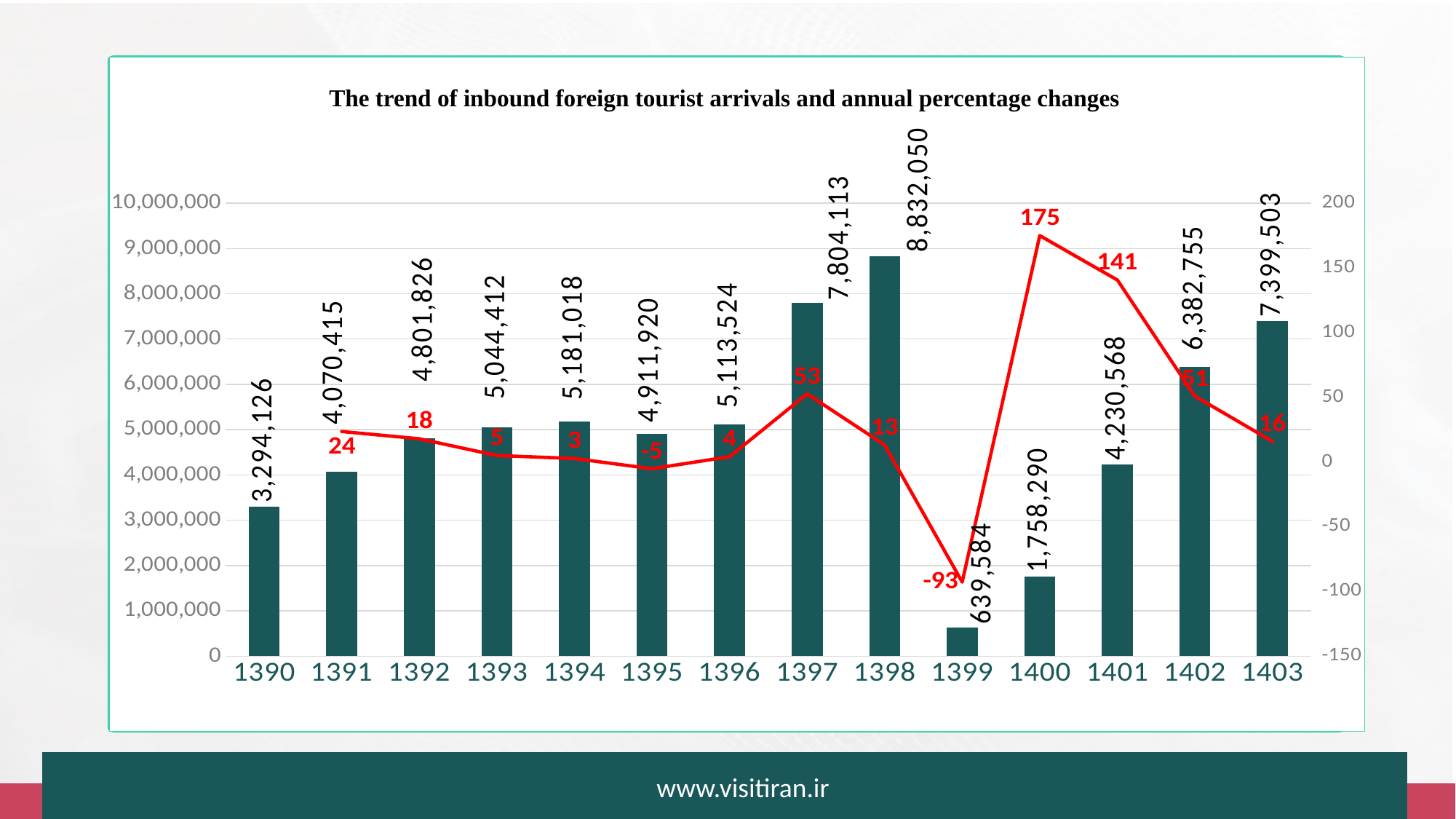
Which year has the lowest annual percentage change on the red line? 1399 Do tourist arrivals rise or fall from 1399 to 1403? Rise Which year has the lowest number of tourist arrivals? 1399 What is the number of inbound foreign tourist arrivals in 1398? 8,832,050 What is the difference in tourist arrivals between 1398 and 1397? 1,027,937 Which year has the highest number of tourist arrivals? 1398 What annual percentage change is shown on the red line for 1395? -5 What is the number of inbound foreign tourist arrivals in 1399? 639,584 What kind of chart is this? Combined bar and line chart What annual percentage change is shown on the red line for 1400? 175 Which year had more tourist arrivals, 1402 or 1403? 1403 How many years are shown on the x axis? 14